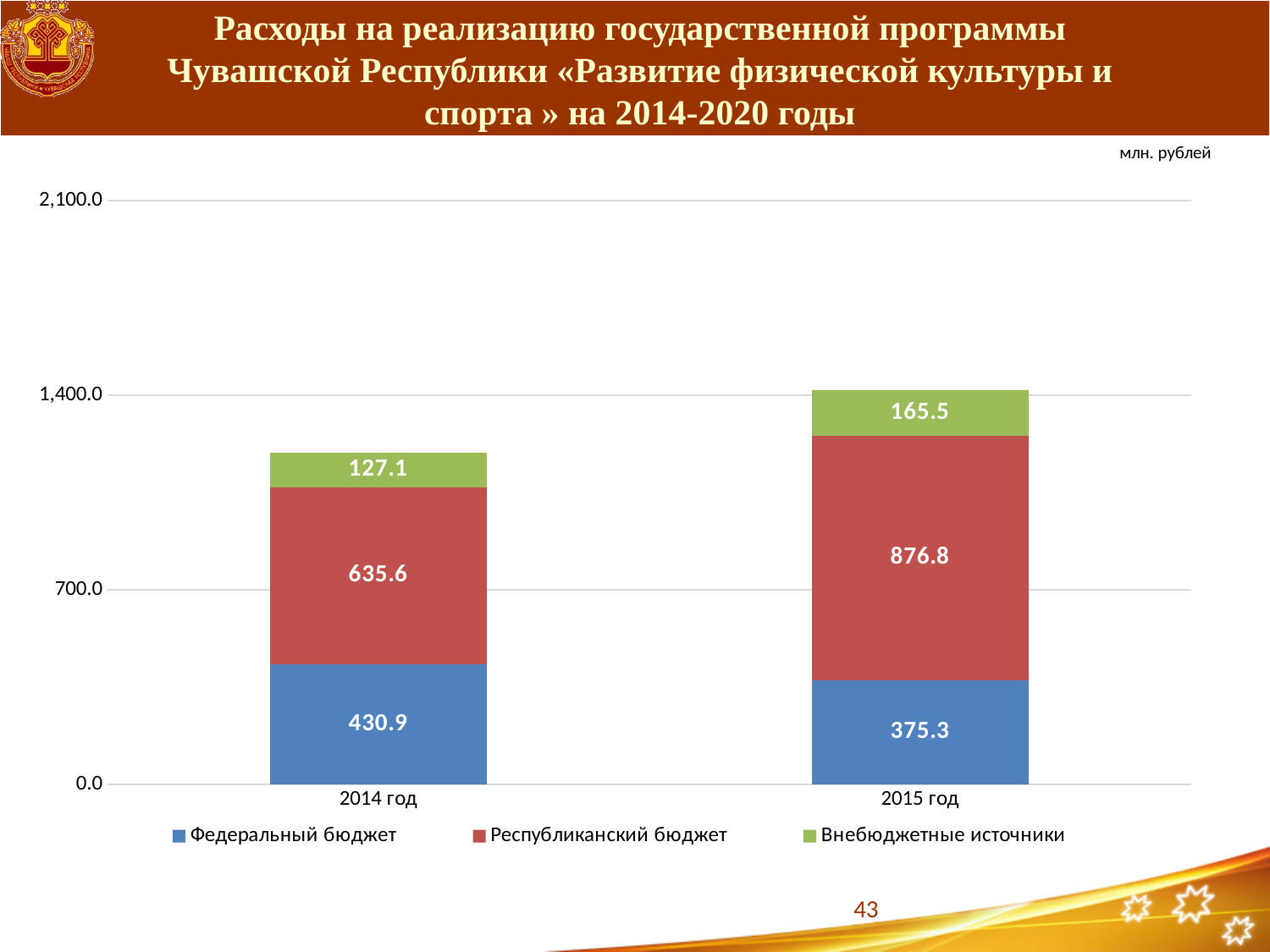
Which is larger: Федеральный бюджет in 2014 год or in 2015 год? 2014 год What is the total of the stacked bar for 2014 год? 1193.6 What is the value for Внебюджетные источники in 2015 год? 165.5 What is the value for Внебюджетные источники in 2014 год? 127.1 What kind of chart is shown on the slide? Stacked bar chart What is the value for Республиканский бюджет in 2015 год? 876.8 How many series does the legend list? 3 What is the difference between Республиканский бюджет in 2015 год and in 2014 год? 241.2 What is the value for Федеральный бюджет in 2014 год? 430.9 Which series has the highest value in 2015 год? Республиканский бюджет How many categories are shown on the x axis? 2 What is the total of the stacked bar for 2015 год? 1417.6